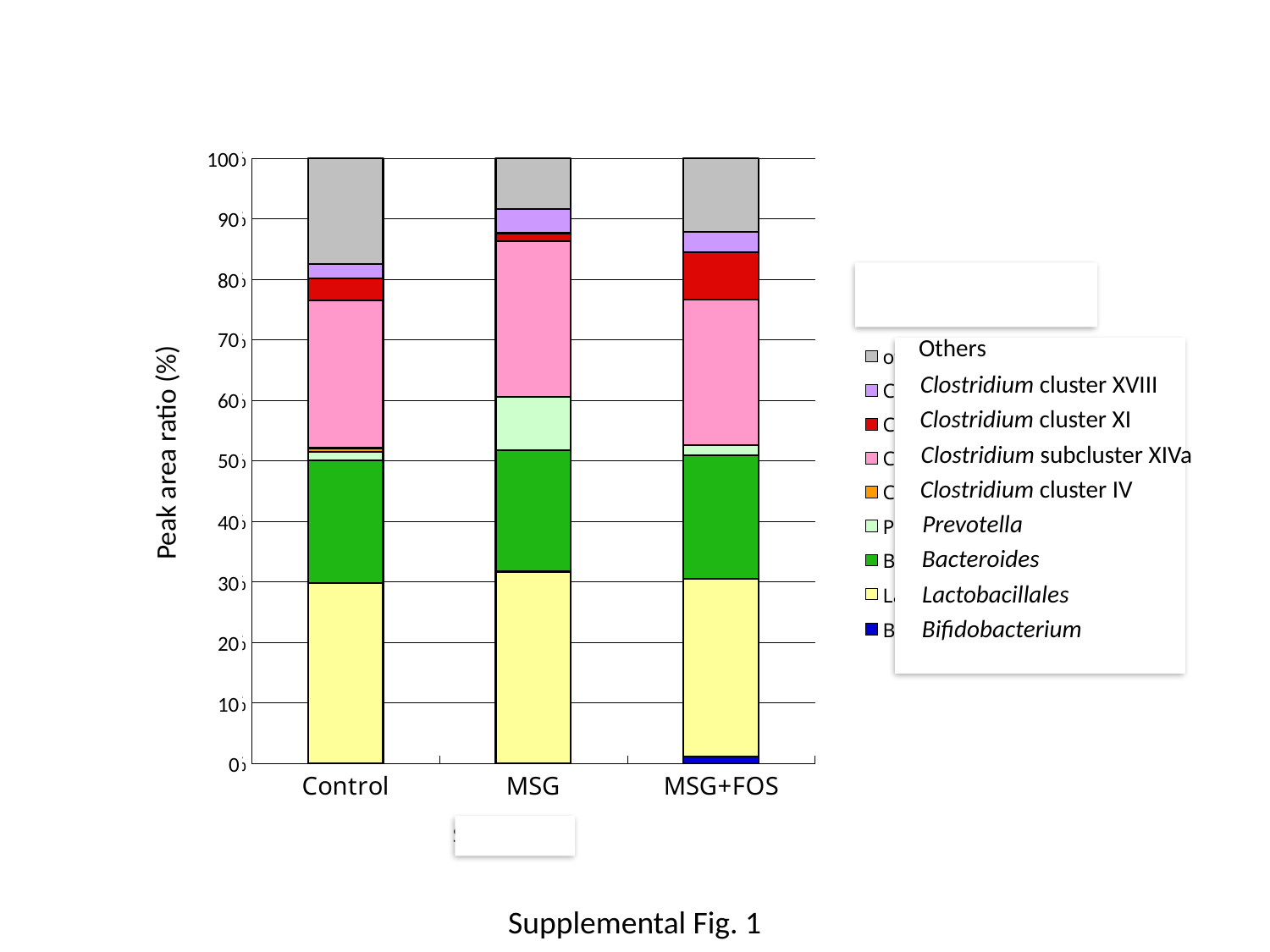
What is the total height of the Control stacked bar? 100 Is the Clostridium subcluster XIVa segment in the Control bar greater or less than 20? greater Which group has the largest Others segment? Control What is the label of the y axis? Peak area ratio (%) Which group has the largest Clostridium cluster XI segment? MSG+FOS What kind of chart is shown on the slide? stacked bar chart Is the Prevotella segment larger in MSG or in Control? MSG Which group is the only one with a visible Bifidobacterium segment? MSG+FOS How many series does the legend list? 9 How many groups (bars) are shown along the x axis? 3 Which group has the largest Prevotella segment? MSG Is the Others segment in the MSG bar greater or less than 10? less